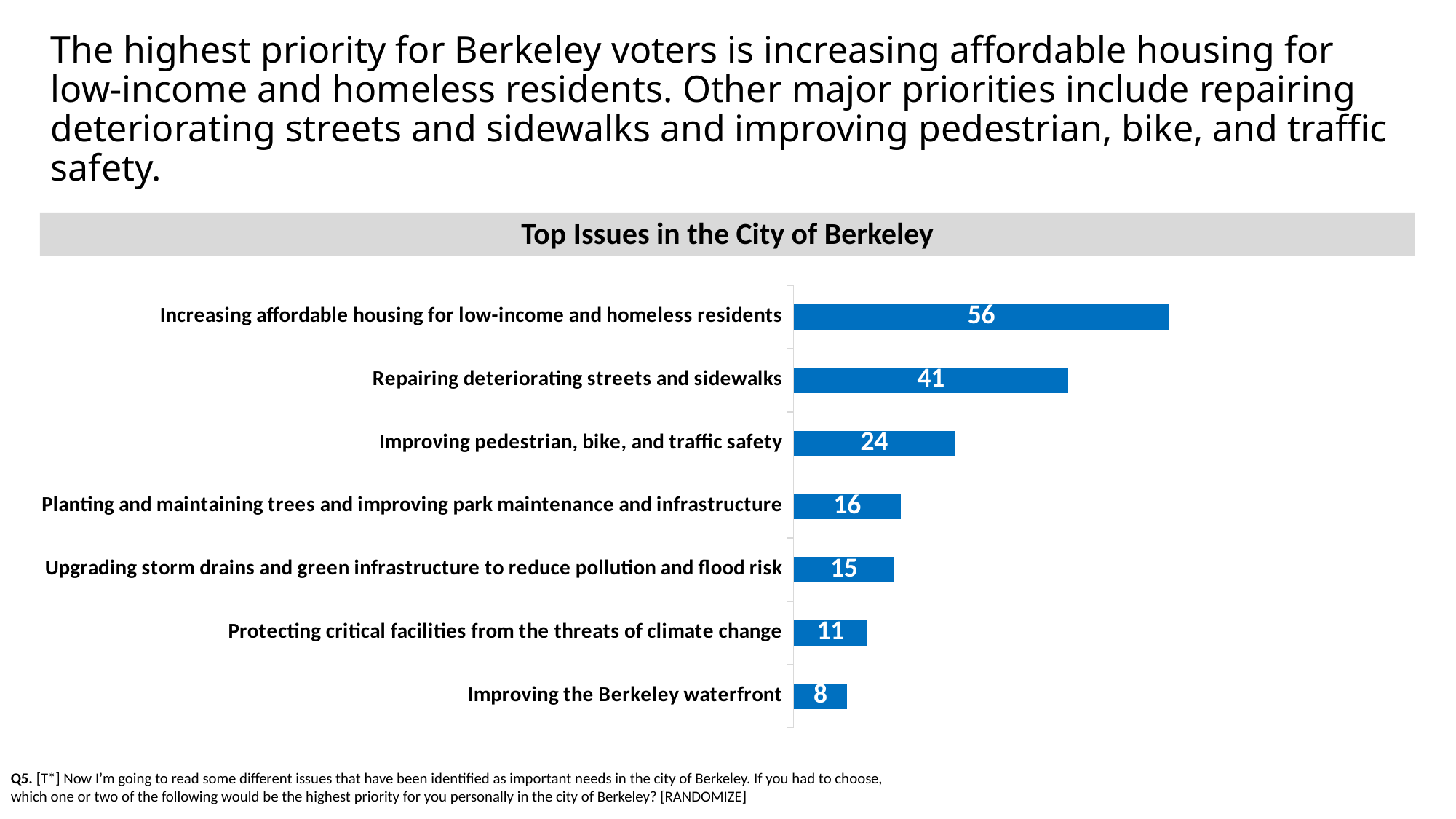
What is the difference between the values for "Improving pedestrian, bike, and traffic safety" and "Improving the Berkeley waterfront"? 16 What is the title of the chart? Top Issues in the City of Berkeley What is the value for "Repairing deteriorating streets and sidewalks"? 41 What is the difference between the values for "Increasing affordable housing for low-income and homeless residents" and "Repairing deteriorating streets and sidewalks"? 15 What kind of chart is shown on the slide? Bar chart What is the value for "Protecting critical facilities from the threats of climate change"? 11 How many categories are shown in the chart? 7 What is the value for "Increasing affordable housing for low-income and homeless residents"? 56 Which category has the highest value? Increasing affordable housing for low-income and homeless residents Which is larger: the value for "Planting and maintaining trees and improving park maintenance and infrastructure" or the value for "Upgrading storm drains and green infrastructure to reduce pollution and flood risk"? Planting and maintaining trees and improving park maintenance and infrastructure Which category has the lowest value? Improving the Berkeley waterfront What is the value for "Improving pedestrian, bike, and traffic safety"? 24